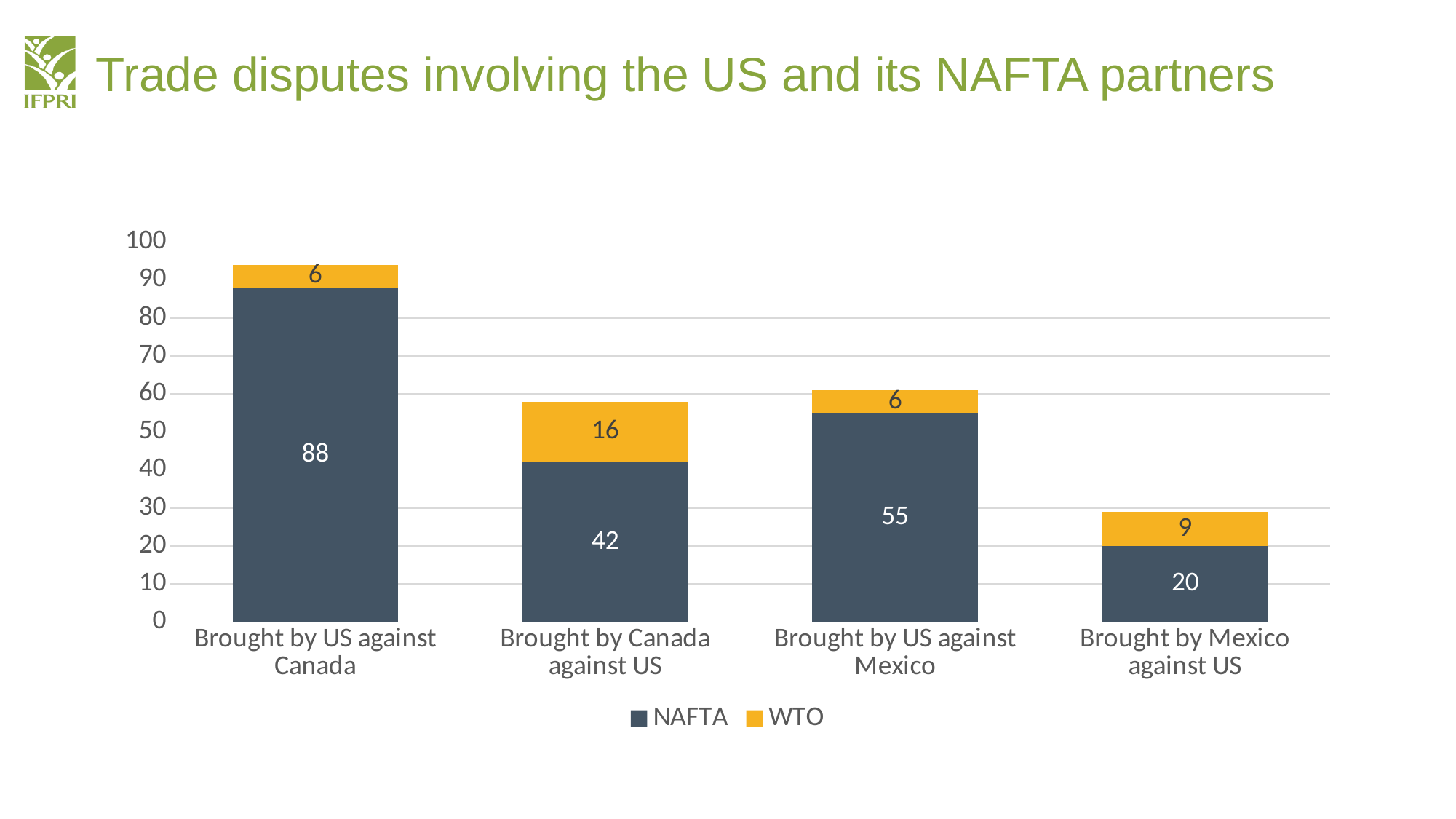
What is the NAFTA value for disputes brought by US against Canada? 88 What is the total of the stacked bar for disputes brought by Canada against US? 58 What kind of chart is shown on the slide? Stacked bar chart Which is larger: the WTO value for disputes brought by Canada against US or the WTO value for disputes brought by Mexico against US? Brought by Canada against US What is the difference between the NAFTA values for disputes brought by US against Canada and brought by US against Mexico? 33 What is the NAFTA value for disputes brought by Mexico against US? 20 What is the total of the stacked bar for disputes brought by Mexico against US? 29 Which category has the lowest WTO value? Brought by US against Canada and Brought by US against Mexico (both 6) What is the WTO value for disputes brought by Canada against US? 16 How many series does the legend list? 2 How many categories are shown on the x axis? 4 Which category has the highest NAFTA value? Brought by US against Canada